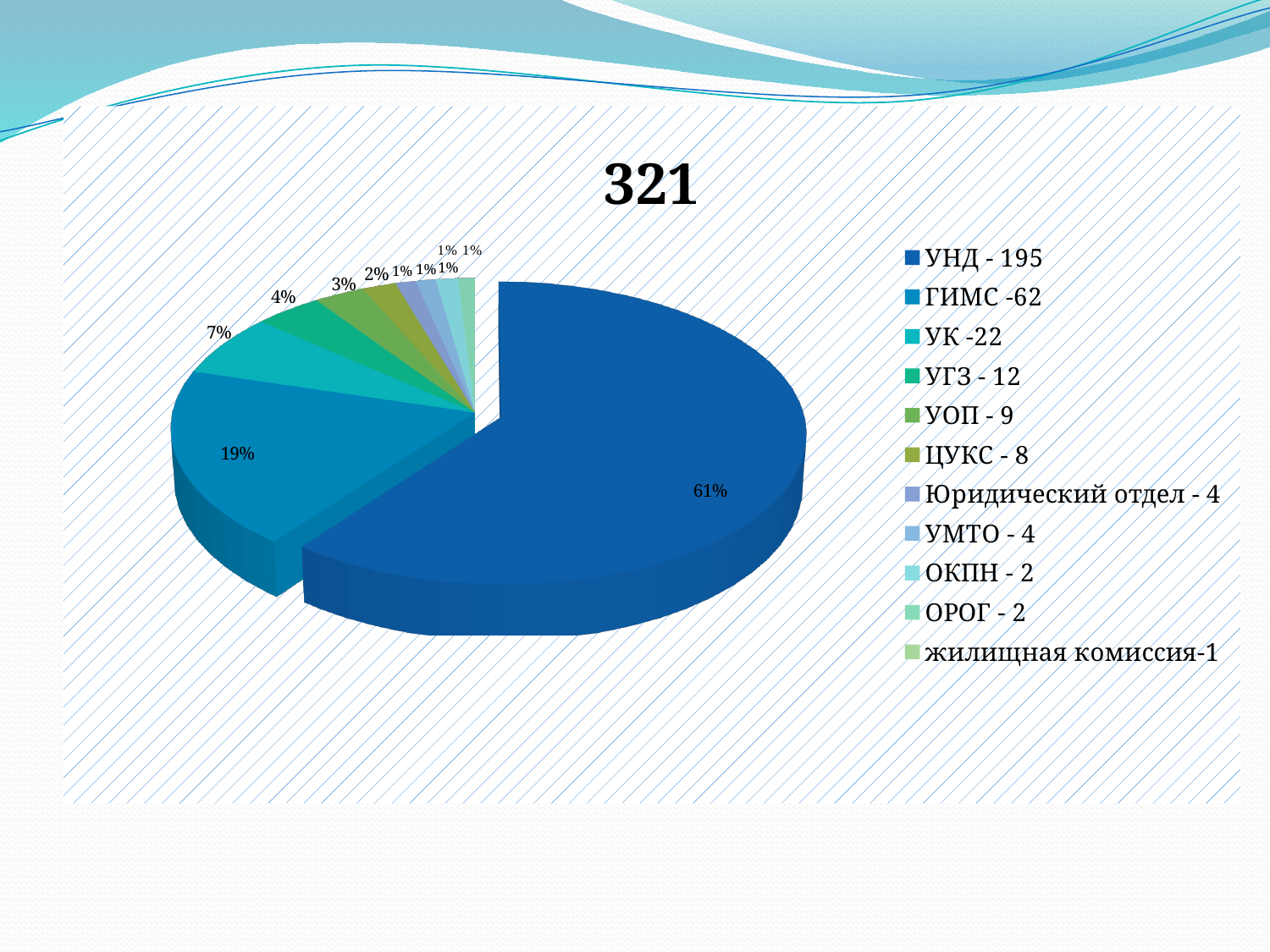
What is the title of the chart? 321 What kind of chart is shown on the slide? pie chart What value is listed for ЦУКС in the legend? 8 What value is listed for УГЗ in the legend? 12 Which category has the largest slice of the pie? УНД Which category has the smallest value according to the legend? жилищная комиссия How many slices does the pie chart have? 11 What share of the pie does ГИМС take? 19% What share of the pie does УК take? 7% What share of the pie does УНД take? 61% What is the difference between the values for УНД and ГИМС shown in the legend? 133 Which has the larger value, УК or УГЗ? УК